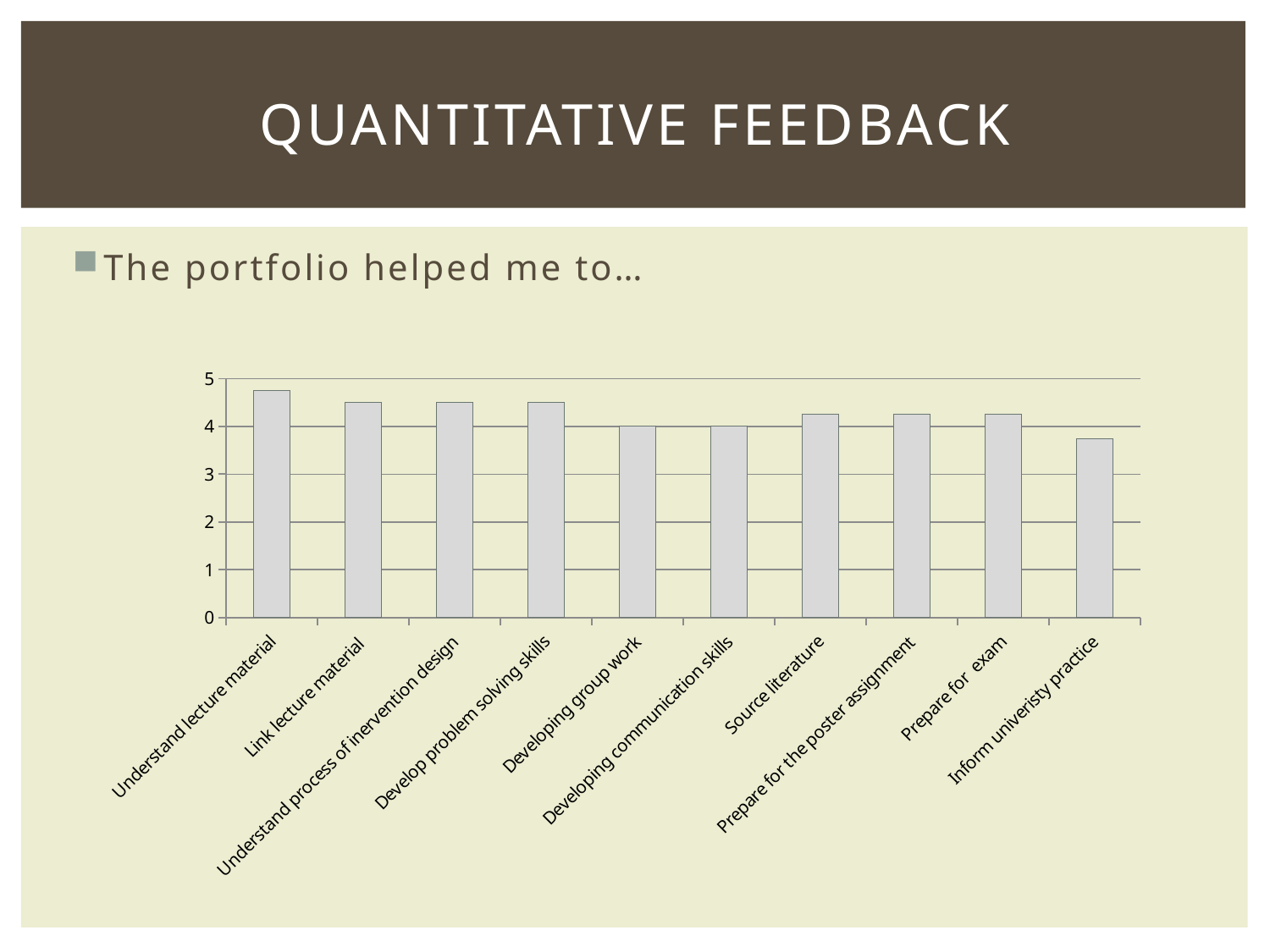
What is the maximum value shown on the vertical axis of the chart? 5 Is the value for Source literature greater or less than 4? greater Which is larger, the value for Understand lecture material or the value for Inform univeristy practice? Understand lecture material Which category has the lowest bar in the chart? Inform univeristy practice Is the value for Inform univeristy practice greater or less than 4? less How many categories are shown on the x axis of the chart? 10 Is the value for Understand lecture material greater or less than 4? greater What is the value for Developing group work? 4 What kind of chart is shown on the slide? bar chart Which category has the highest bar in the chart? Understand lecture material What is the value for Developing communication skills? 4